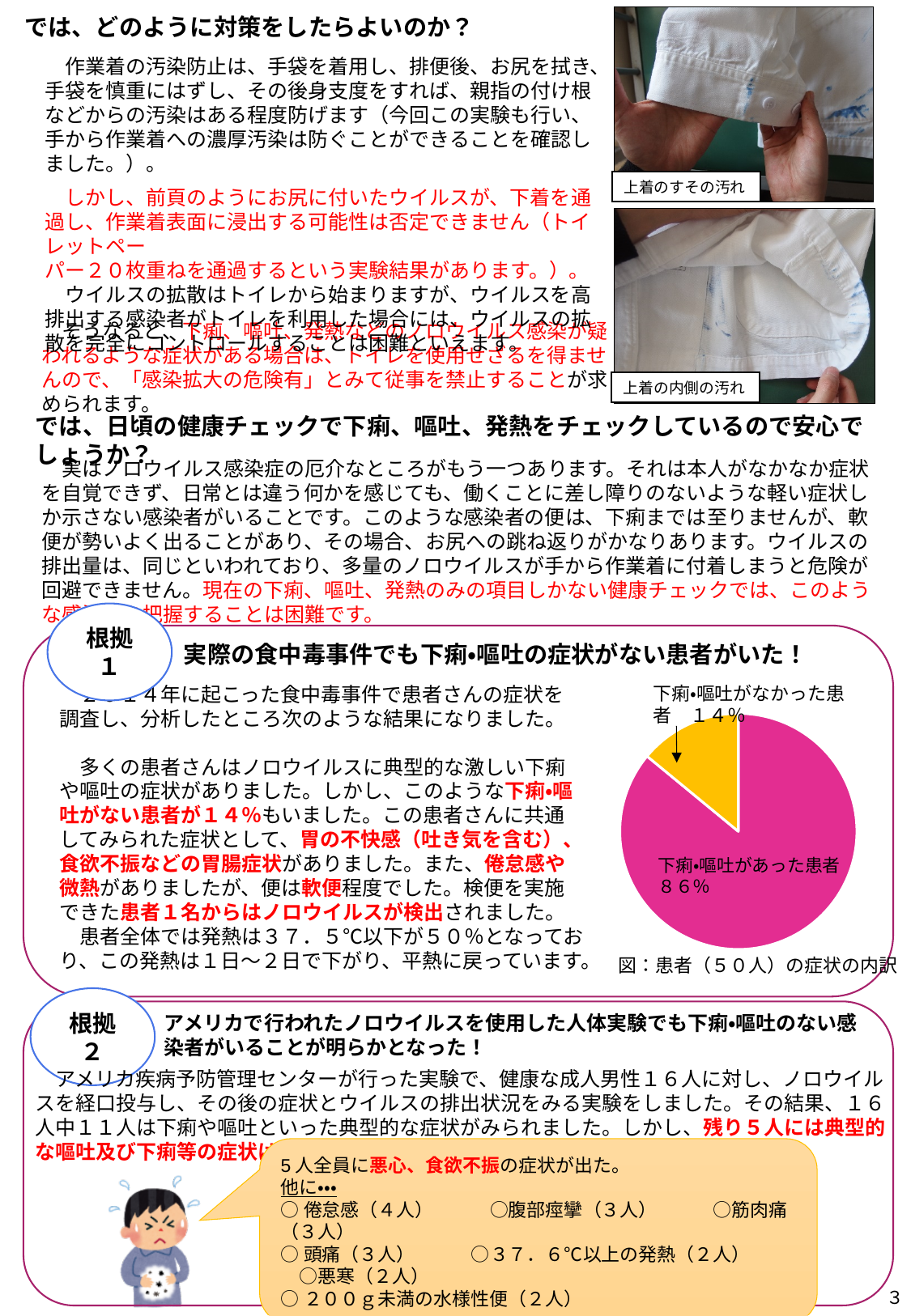
Which slice of the pie chart is the largest? 下痢•嘔吐があった患者 In the pie chart, what percentage of patients had no diarrhea or vomiting (下痢•嘔吐がなかった患者)? 14% In the pie chart, which is larger: the share of patients with diarrhea/vomiting or the share without? 下痢•嘔吐があった患者 How many patients does the pie chart's caption say were included? 50人 What kind of chart is shown in the figure 「患者（50人）の症状の内訳」? pie chart Which slice of the pie chart is the smallest? 下痢•嘔吐がなかった患者 How many slices does the pie chart have? 2 What is the share of the pie taken by the 下痢•嘔吐がなかった患者 slice? 14% In the pie chart, what is the difference in percentage points between patients with diarrhea/vomiting and those without? 72 In the pie chart, what percentage of patients had diarrhea or vomiting (下痢•嘔吐があった患者)? 86% What colour is the 下痢•嘔吐があった患者 slice in the pie chart? magenta (pink)